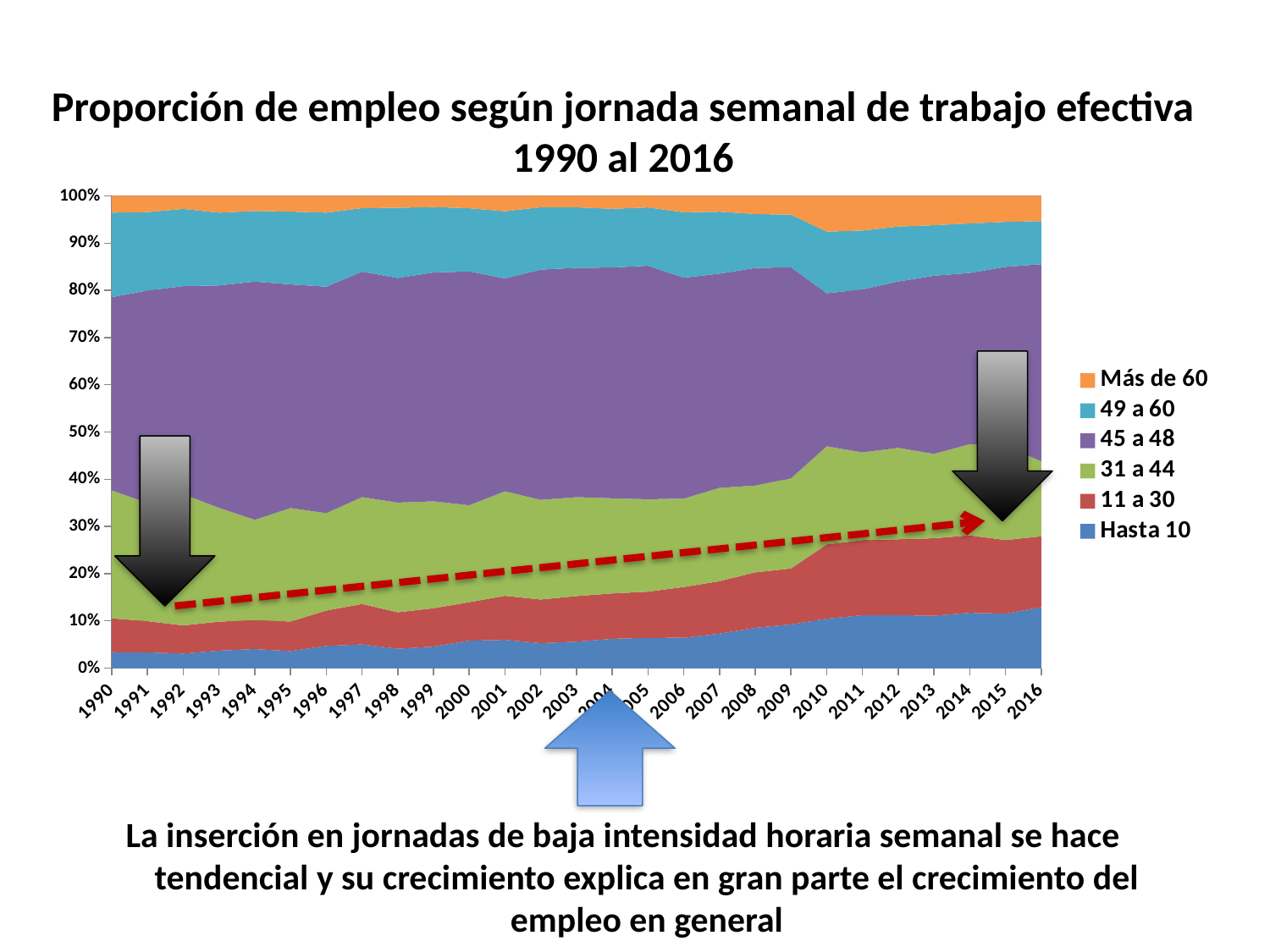
How many years are plotted along the x axis? 27 Is the value for 'Hasta 10' in 2016 greater or less than 10%? greater In 1990, which series has the larger share: '45 a 48' or '49 a 60'? 45 a 48 Is the cumulative top of the '31 a 44' band in 2016 greater or less than 40%? greater Does the share of the 'Hasta 10' series rise or fall from 1990 to 2016? Rise What kind of chart is shown on the slide? Stacked area chart Is the cumulative top of the '45 a 48' band in 2016 greater or less than 80%? greater Which series has the largest share in 1990? 45 a 48 What colour represents the 'Más de 60' series? Orange How many series does the legend list? 6 Which series is listed at the bottom of the legend? Hasta 10